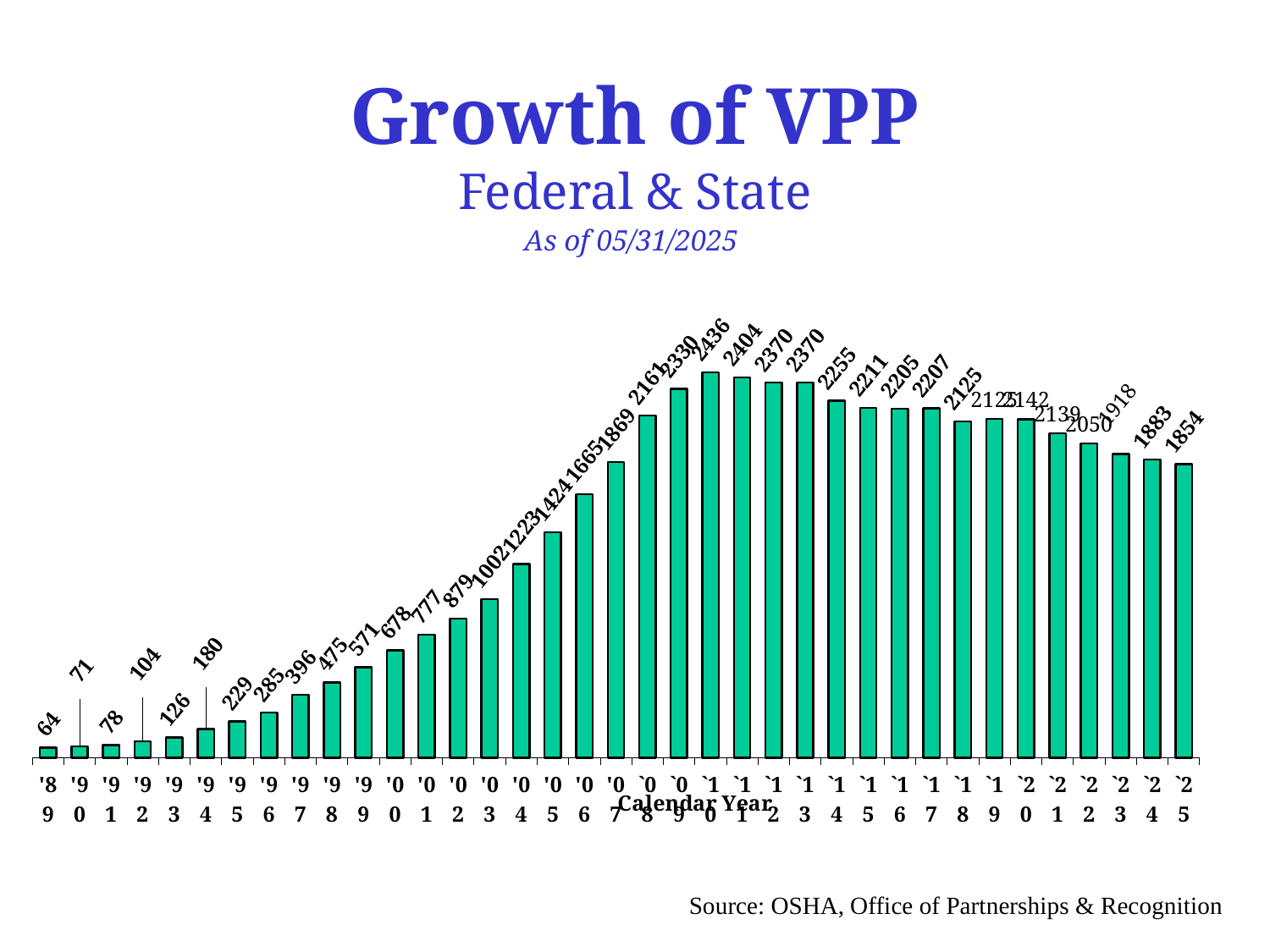
How many calendar years are plotted on the chart? 37 What is the difference between the value for '10 and the value for '25? 582 Which is larger, the value for '08 or the value for '09? '09 Which calendar year has the lowest value? '89 What is the value for calendar year '25? 1854 Do the values rise or fall from '89 to '10? rise What is the label of the x axis? Calendar Year Which calendar year has the highest value? '10 What is the value for calendar year '00? 678 What is the value for calendar year '10? 2436 What kind of chart is shown on the slide? bar chart What is the value for calendar year '89? 64